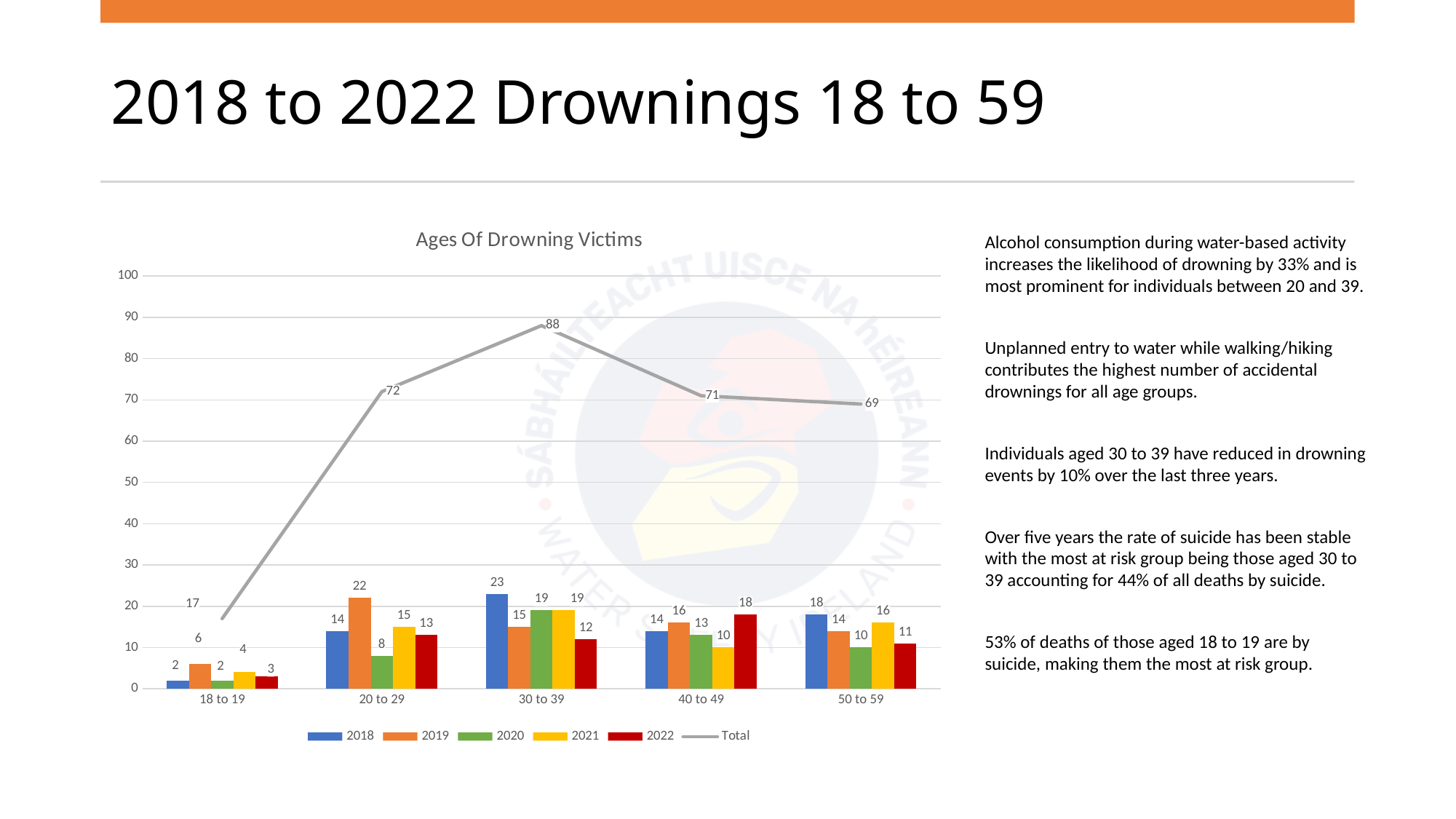
Which is larger: the 2018 value for 30 to 39 or the 2018 value for 50 to 59? 30 to 39 What is the 2019 value for the 20 to 29 age group? 22 What is the title of the chart? Ages Of Drowning Victims Is the Total value for the 40 to 49 age group greater or less than 60? greater What is the 2022 value for the 40 to 49 age group? 18 What is the Total value for the 30 to 39 age group? 88 Which series is drawn as a line rather than bars? Total How many age groups are shown on the x axis? 5 Which age group has the lowest Total value? 18 to 19 What is the difference between the Total values for the 30 to 39 and 20 to 29 age groups? 16 Which age group has the highest Total value? 30 to 39 How many series does the legend list? 6